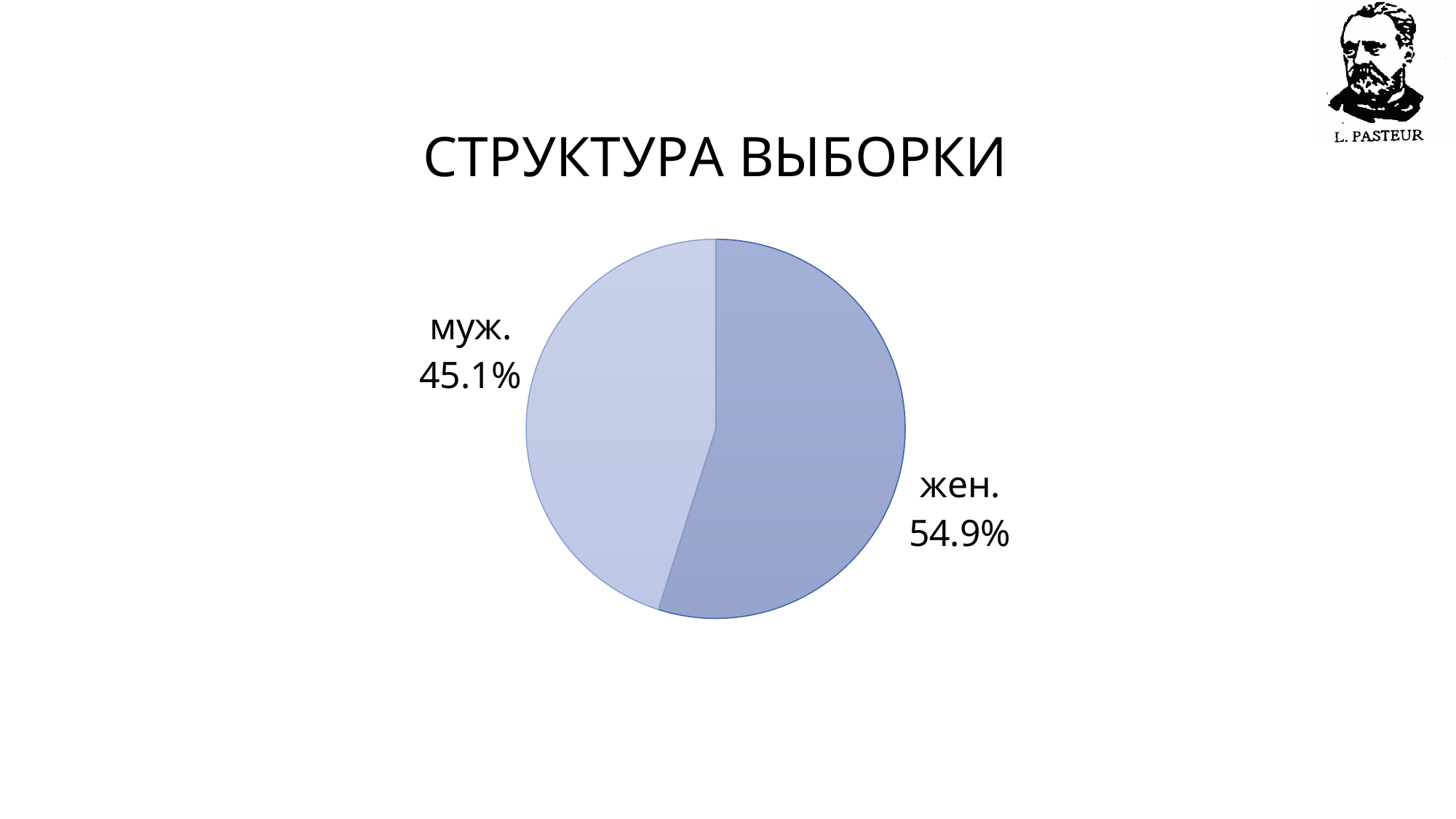
How many slices does the pie chart have? 2 Which category has the largest share of the pie? жен. Is the share for жен. greater or less than 50%? greater Which is larger, the share for жен. or the share for муж.? жен. What kind of chart is shown on the slide? pie chart Which slice is shown in the lighter shade of blue? муж. What share of the sample is муж.? 45.1% What is the difference in percentage points between the жен. and муж. shares? 9.8 What is the title of the slide containing the pie chart? СТРУКТУРА ВЫБОРКИ Is the share for муж. greater or less than 50%? less Which category has the smallest share of the pie? муж. What share of the sample is жен.? 54.9%